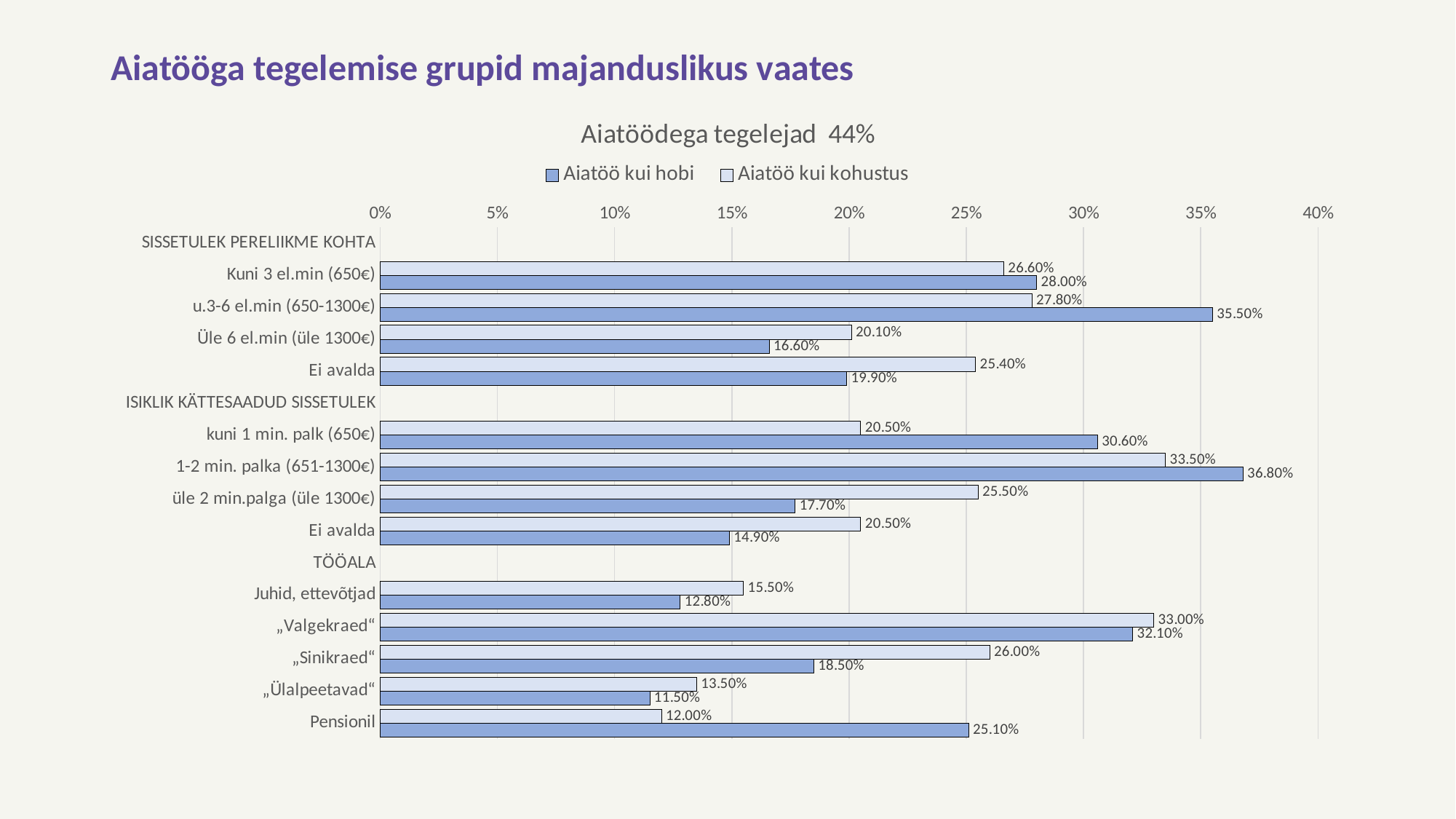
Which category has the lowest value for "Aiatöö kui kohustus"? Pensionil What is the value of "Aiatöö kui hobi" for "„Valgekraed“"? 32.10% What is the value of "Aiatöö kui kohustus" for "Juhid, ettevõtjad"? 15.50% What is the title of the chart? Aiatöödega tegelejad 44% Is the value of "Aiatöö kui hobi" for "kuni 1 min. palk (650€)" greater or less than 25%? greater What is the value of "Aiatöö kui hobi" for "u.3-6 el.min (650-1300€)"? 35.50% Which category has the highest value for "Aiatöö kui hobi"? 1-2 min. palka (651-1300€) What kind of chart is shown on the slide? Bar chart What is the difference between "Aiatöö kui hobi" and "Aiatöö kui kohustus" for "Pensionil"? 13.10% How many series does the legend list? 2 For "„Sinikraed“", which is larger: "Aiatöö kui hobi" or "Aiatöö kui kohustus"? Aiatöö kui kohustus What is the value of "Aiatöö kui kohustus" for "Pensionil"? 12.00%